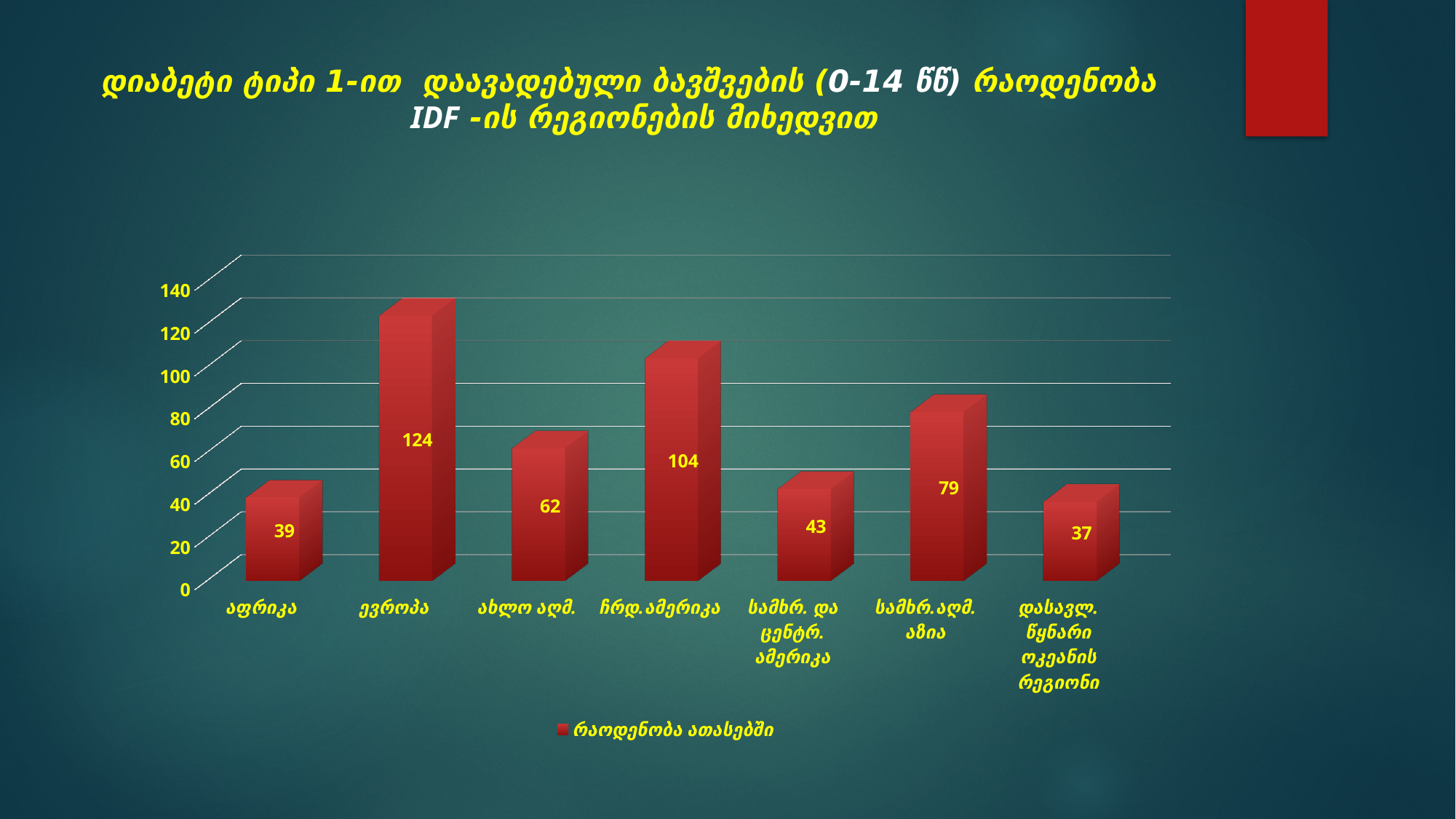
What kind of chart is shown on the slide? bar chart What is the difference between the values for ევროპა and ჩრდ. ამერიკა? 20 Which is larger, the value for ახლო აღმ. or the value for სამხრ. და ცენტრ. ამერიკა? ახლო აღმ. How many categories are shown on the x axis? 7 What is the legend entry for the series? რაოდენობა ათასებში What is the value for ჩრდ. ამერიკა? 104 Which category has the highest value? ევროპა How many series does the legend list? 1 Is the value for სამხრ.აღმ. აზია greater or less than 100? less What is the value for სამხრ.აღმ. აზია? 79 Which category has the lowest value? დასავლ. წყნარი ოკეანის რეგიონი What is the value for ევროპა? 124